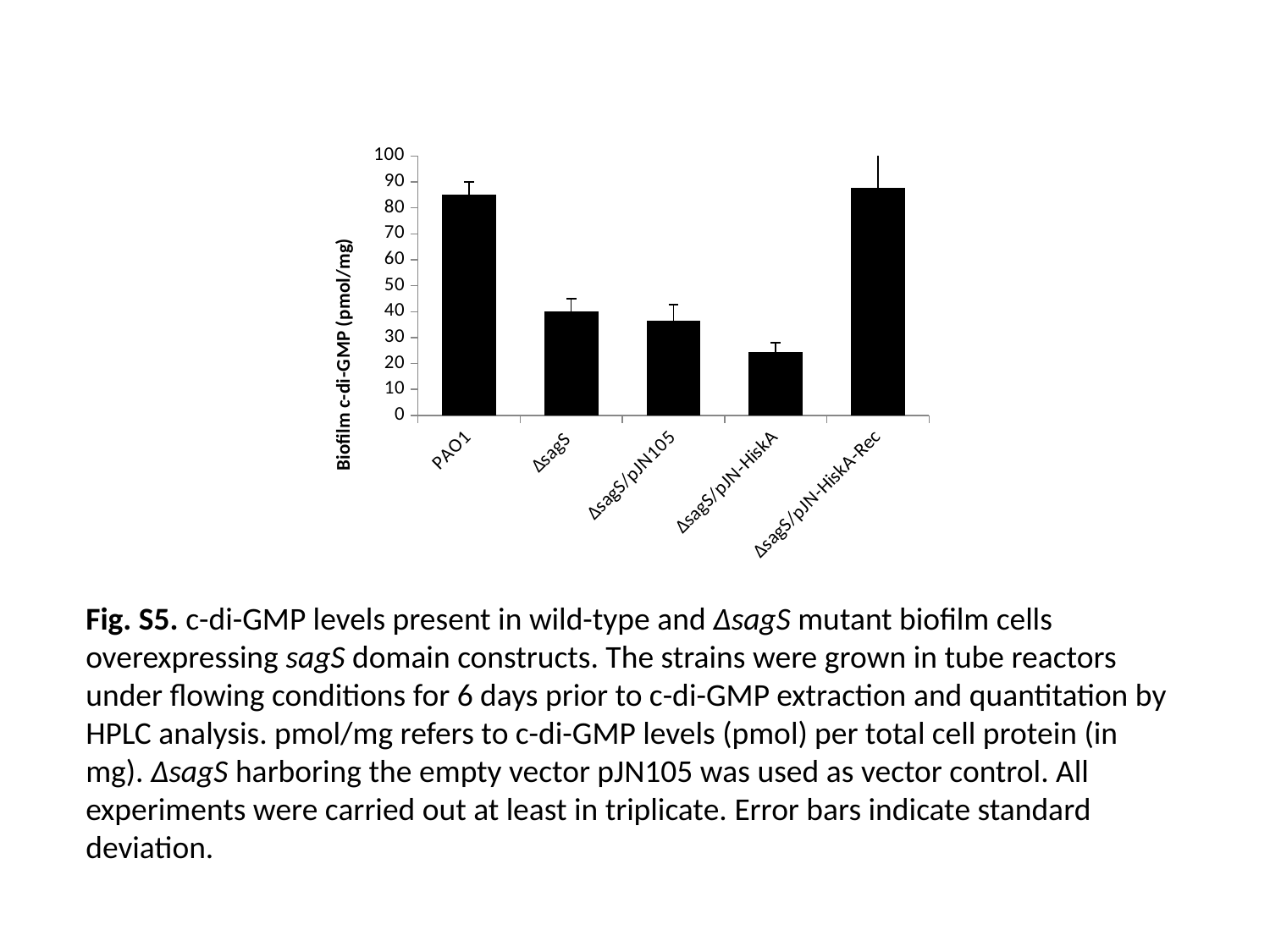
How many strains (categories) are plotted on the x axis? 5 Is the value for ΔsagS/pJN105 greater or less than 30? greater Is the value for ΔsagS/pJN-HiskA-Rec greater or less than 80? greater Is the value for ΔsagS greater or less than 50? less Which has a higher biofilm c-di-GMP level, ΔsagS/pJN-HiskA-Rec or ΔsagS/pJN-HiskA? ΔsagS/pJN-HiskA-Rec Which has a higher biofilm c-di-GMP level, PAO1 or ΔsagS? PAO1 Which strain has the lowest biofilm c-di-GMP level? ΔsagS/pJN-HiskA What kind of chart is shown on the slide? bar chart Which has a higher biofilm c-di-GMP level, ΔsagS/pJN105 or ΔsagS/pJN-HiskA? ΔsagS/pJN105 What is the label of the y axis? Biofilm c-di-GMP (pmol/mg)